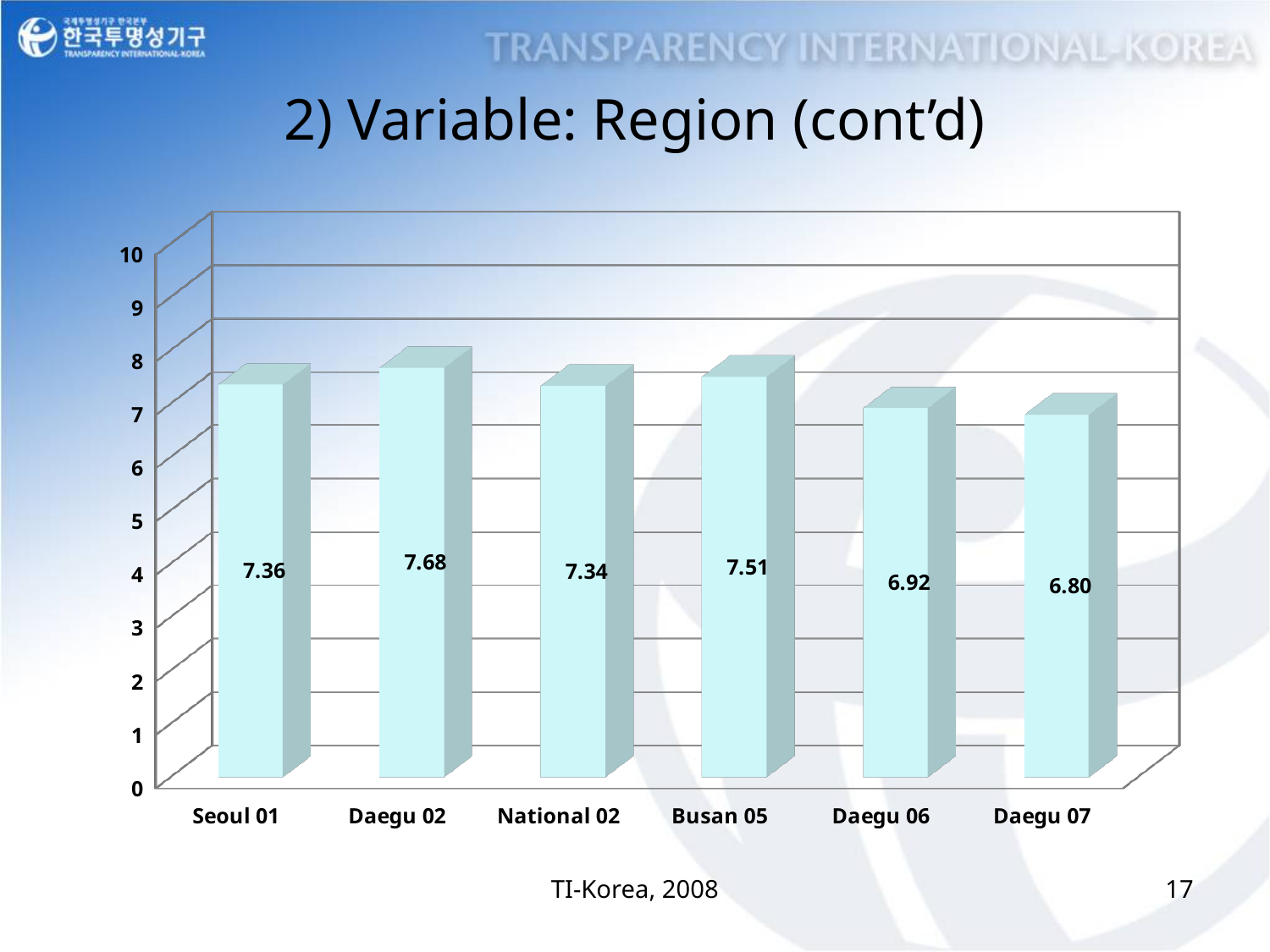
Is the value for Daegu 06 greater or less than 7? less What is the value for Daegu 07? 6.80 What is the difference between the values for Busan 05 and Daegu 06? 0.59 Which category has the highest value? Daegu 02 What kind of chart is shown on the slide? bar chart Which is larger, the value for Busan 05 or the value for National 02? Busan 05 Which category has the lowest value? Daegu 07 What is the value for Daegu 02? 7.68 What is the value for Seoul 01? 7.36 What is the difference between the values for Daegu 02 and Daegu 07? 0.88 How many categories are shown on the x axis? 6 What is the maximum value shown on the vertical axis? 10